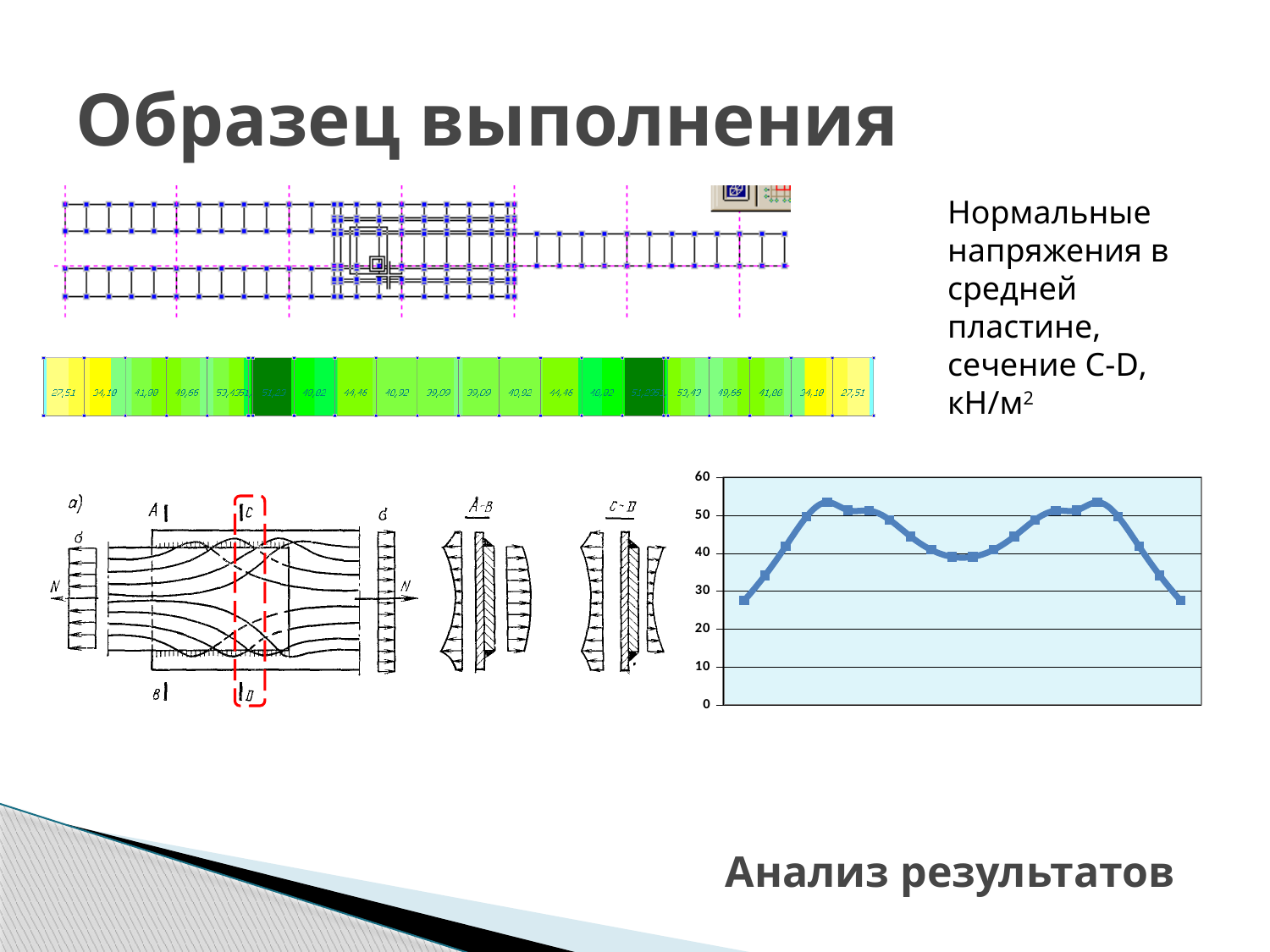
In the line chart at the bottom right, is the value of the highest point greater or less than 60? less In the line chart at the bottom right, does the line rise or fall over the last five points on the right? falls What is the maximum value shown on the vertical axis of the line chart at the bottom right? 60 In the line chart at the bottom right, does the line rise or fall over the first five points from the left? rises In the line chart at the bottom right, is the value of the last (rightmost) point greater or less than 30? less In the line chart at the bottom right, is the value of the first (leftmost) point greater or less than 30? less In the line chart at the bottom right, which is larger: the value of the first point or the value of the highest peak? the highest peak What kind of chart is shown at the bottom right of the slide? line chart What colour is the line in the chart at the bottom right of the slide? blue